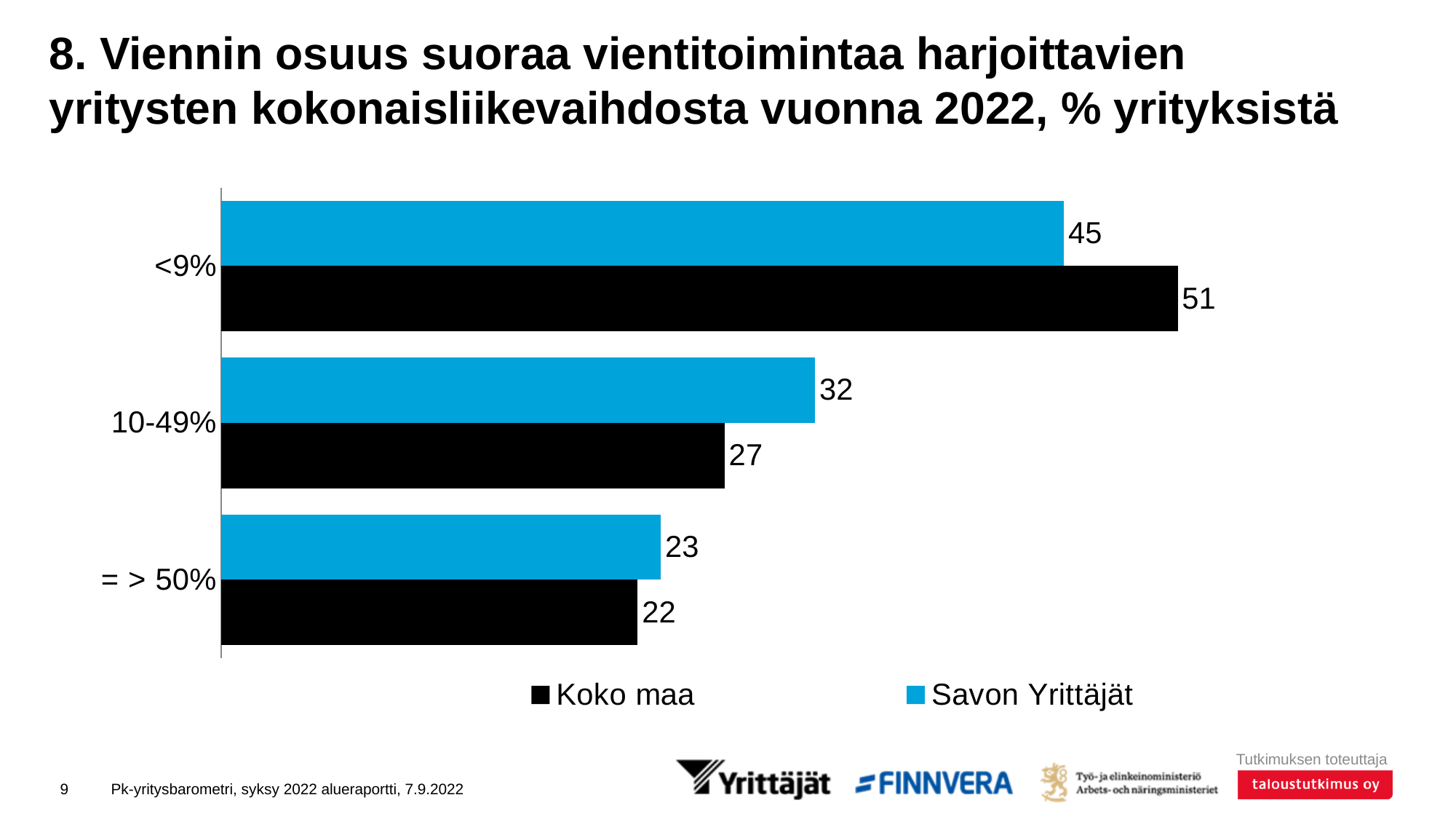
Which category has the highest value for Koko maa? <9% What colour are the bars for Savon Yrittäjät? Blue What is the value for Savon Yrittäjät in the = > 50% category? 23 What is the value for Savon Yrittäjät in the 10-49% category? 32 What kind of chart is shown on the slide? Bar chart Which series has the larger value in the 10-49% category, Koko maa or Savon Yrittäjät? Savon Yrittäjät How many categories are shown on the chart? 3 What is the difference between Koko maa and Savon Yrittäjät in the <9% category? 6 Which category has the lowest value for Savon Yrittäjät? = > 50% What is the difference between Savon Yrittäjät and Koko maa in the 10-49% category? 5 How many series does the legend list? 2 What is the value for Koko maa in the <9% category? 51